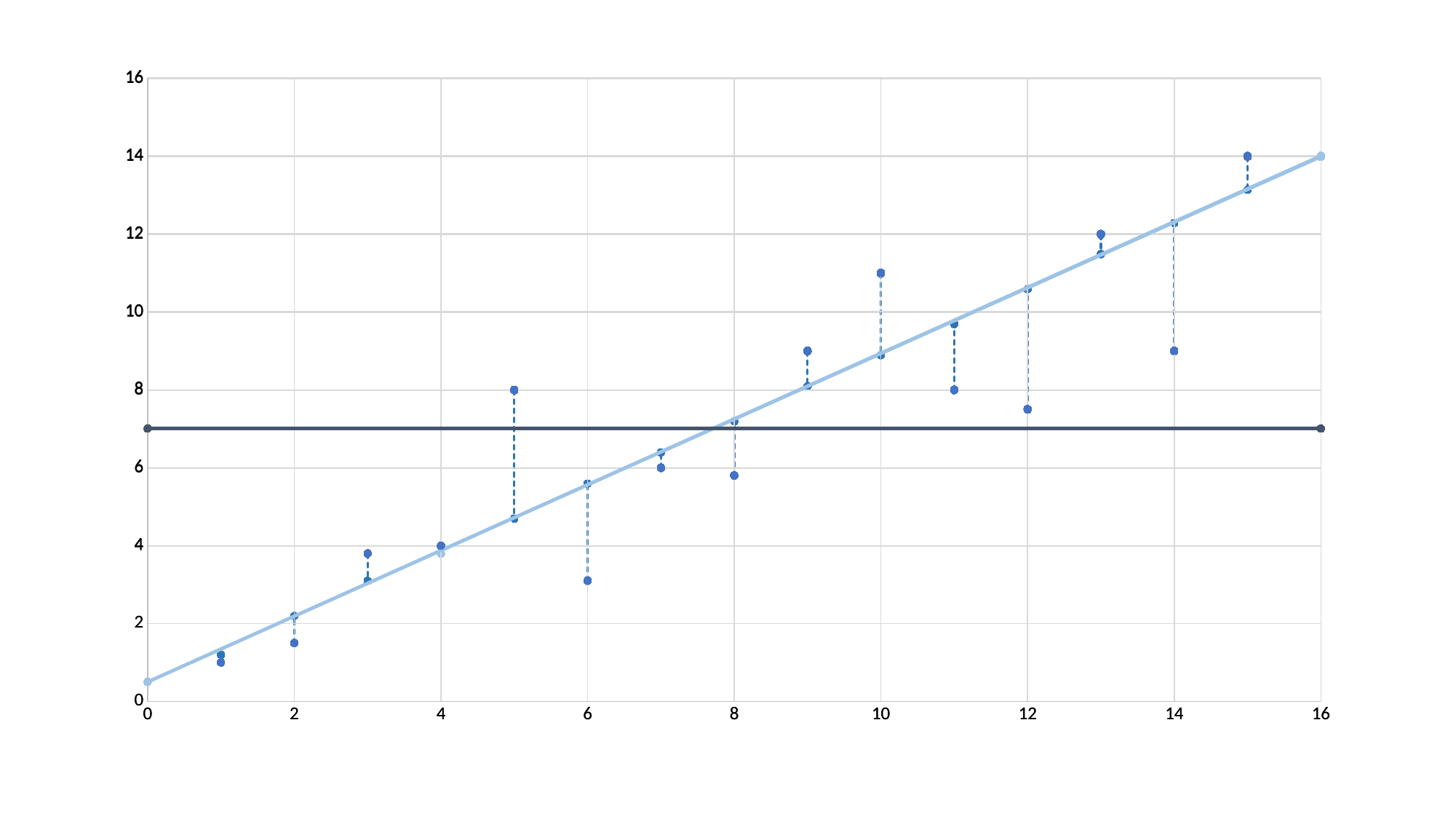
Which data point has the larger y value, the one at x = 5 or the one at x = 6? x = 5 What kind of chart is shown on the slide? scatter chart What is the y value of the data point at x = 5? 8 What is the y value of the data point at x = 11? 8 Do the data points generally rise or fall as x increases? rise At which x value is the highest data point located? 15 Is the y value of the data point at x = 6 greater or less than 4? less What is the difference between the y values of the data points at x = 13 and x = 5? 4 Is the y value of the data point at x = 10 greater or less than 10? greater Is the y value of the data point at x = 14 greater or less than 10? less What is the y value of the data point at x = 15? 14 What is the y value of the data point at x = 13? 12